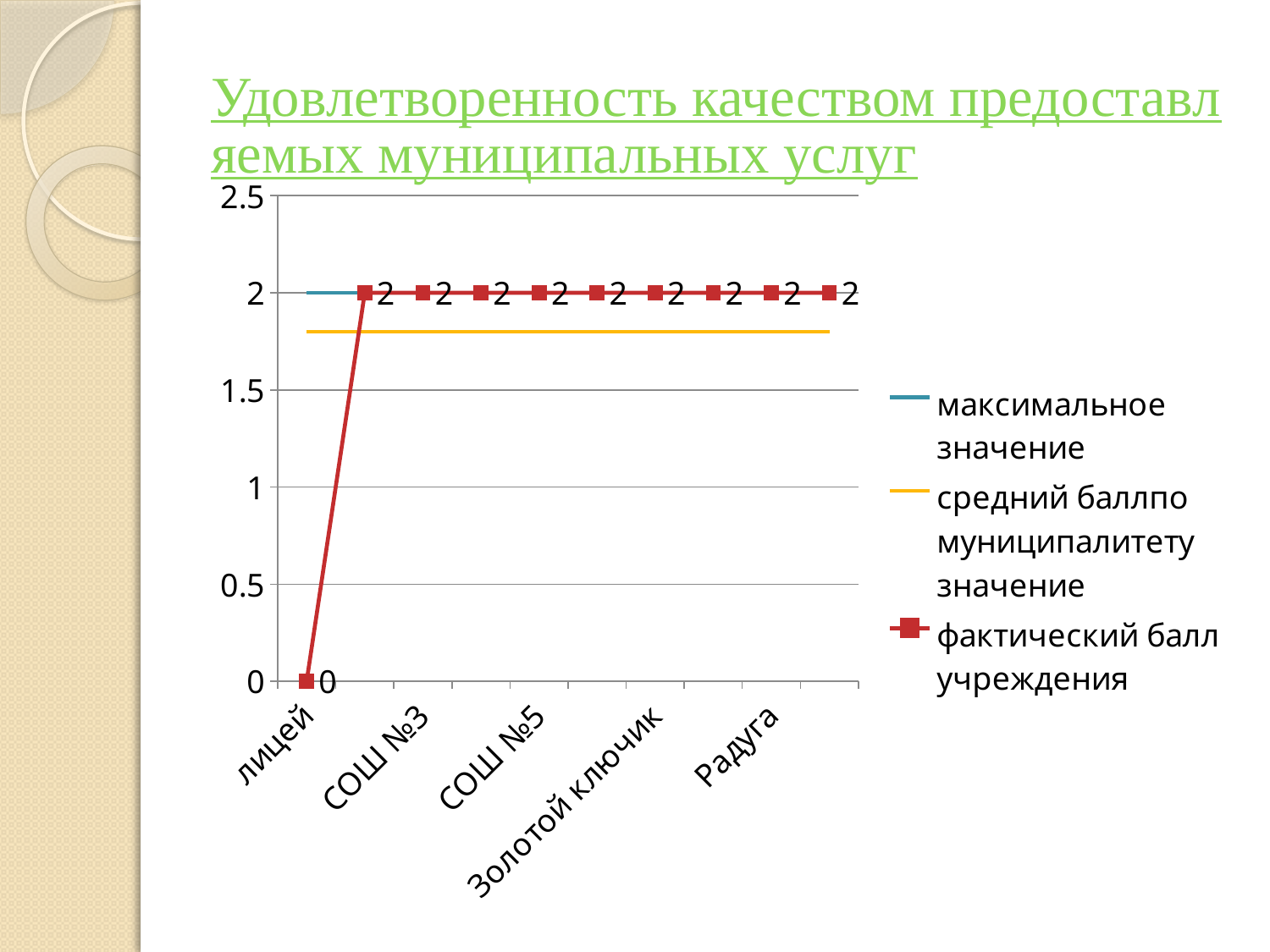
What is the value of 'фактический балл учреждения' for СОШ №3? 2 How many category labels are shown on the x axis? 5 What is the value of 'фактический балл учреждения' for Радуга? 2 Which category has the lowest value for 'фактический балл учреждения'? лицей Is the value of 'средний балл по муниципалитету значение' greater or less than 2? less What kind of chart is shown on the slide? line chart What is the difference between the 'фактический балл учреждения' values for СОШ №3 and лицей? 2 Is the value of 'средний балл по муниципалитету значение' greater or less than 1.5? greater How many series does the legend list? 3 What is the value of 'фактический балл учреждения' for лицей? 0 Which has the larger 'фактический балл учреждения' value, СОШ №5 or лицей? СОШ №5 Which series is drawn with square markers? фактический балл учреждения